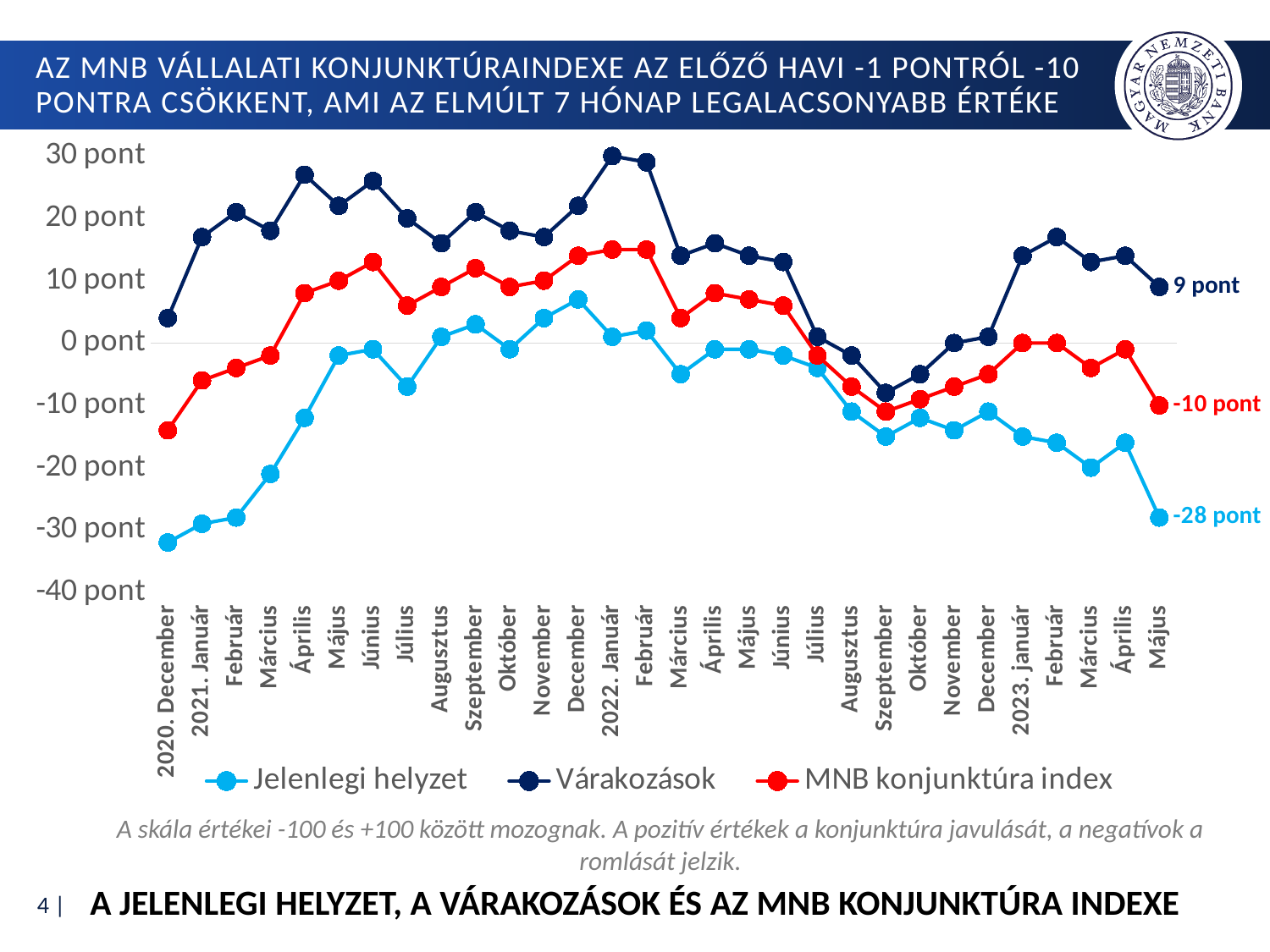
What is the difference between the Várakozások value and the MNB konjunktúra index value in 2023 Május? 19 pont What is the value of the Jelenlegi helyzet series in 2023 Május? -28 pont How many series does the legend list? 3 What is the difference between the MNB konjunktúra index value and the Jelenlegi helyzet value in 2023 Május? 18 pont What kind of chart is shown on the slide? line chart Is the value of the Várakozások series in 2022. Január greater or less than 20 pont? greater What is the value of the Várakozások series in 2023 Május? 9 pont What is the value of the MNB konjunktúra index in 2023 Május? -10 pont In 2023 Május, which is larger: the Várakozások value or the Jelenlegi helyzet value? Várakozások Which series has the lowest value in 2023 Május? Jelenlegi helyzet Is the value of the Jelenlegi helyzet series in 2020. December greater or less than -30 pont? less Does the Jelenlegi helyzet series rise or fall from 2023 Április to 2023 Május? fall